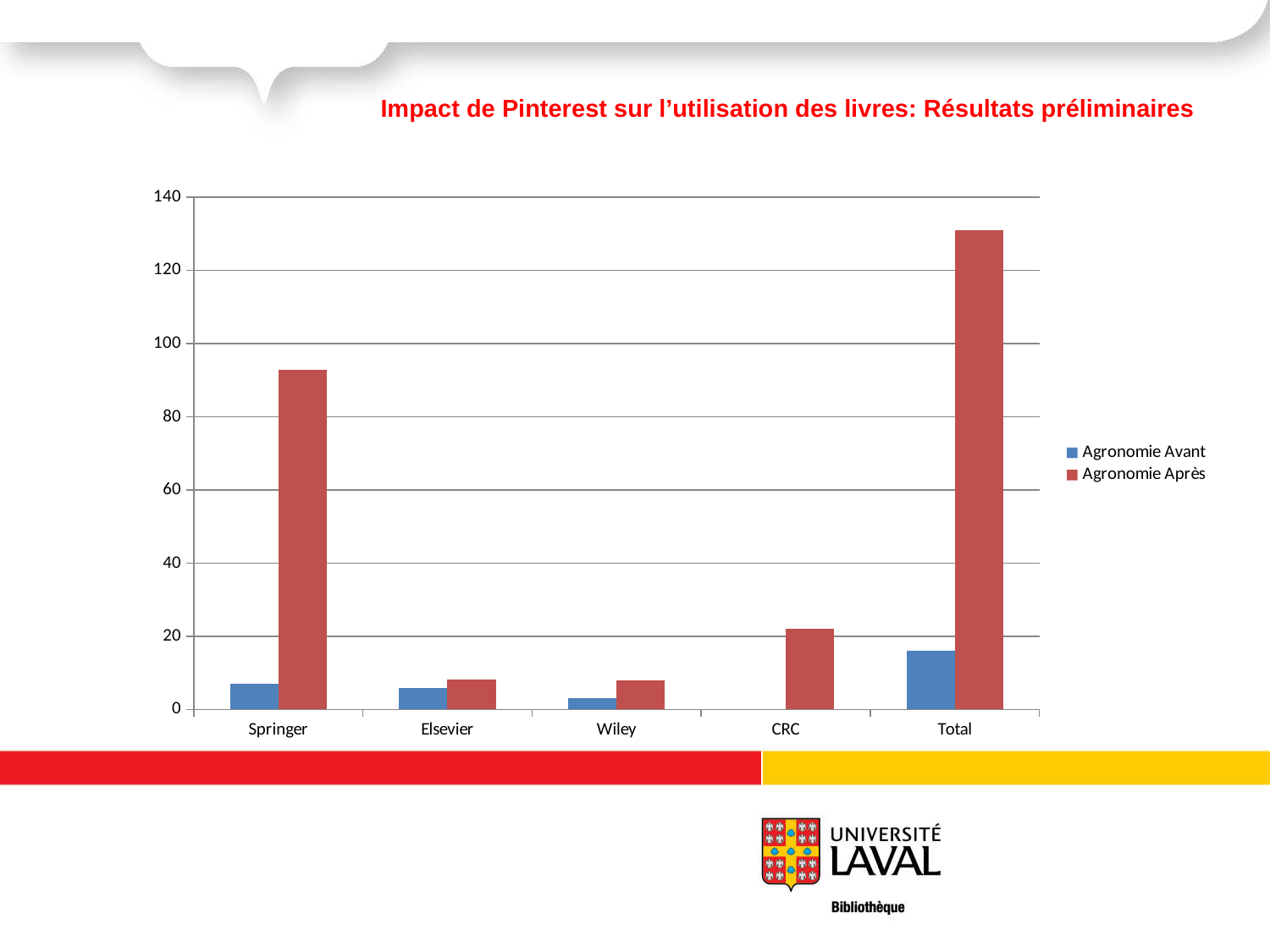
For Springer, which series has the larger value, Agronomie Avant or Agronomie Après? Agronomie Après What is the title of the slide above the chart? Impact de Pinterest sur l'utilisation des livres: Résultats préliminaires Which category has the highest value for Agronomie Avant? Total How many series does the legend list? 2 Which is larger, the Agronomie Après value for Springer or for Total? Total What kind of chart is shown on the slide? bar chart Is the Agronomie Après value for CRC greater or less than 40? less Is the Agronomie Avant value for Total greater or less than 20? less Which category has the highest value for Agronomie Après? Total Is the Agronomie Après value for Springer greater or less than 80? greater How many categories are shown on the x axis? 5